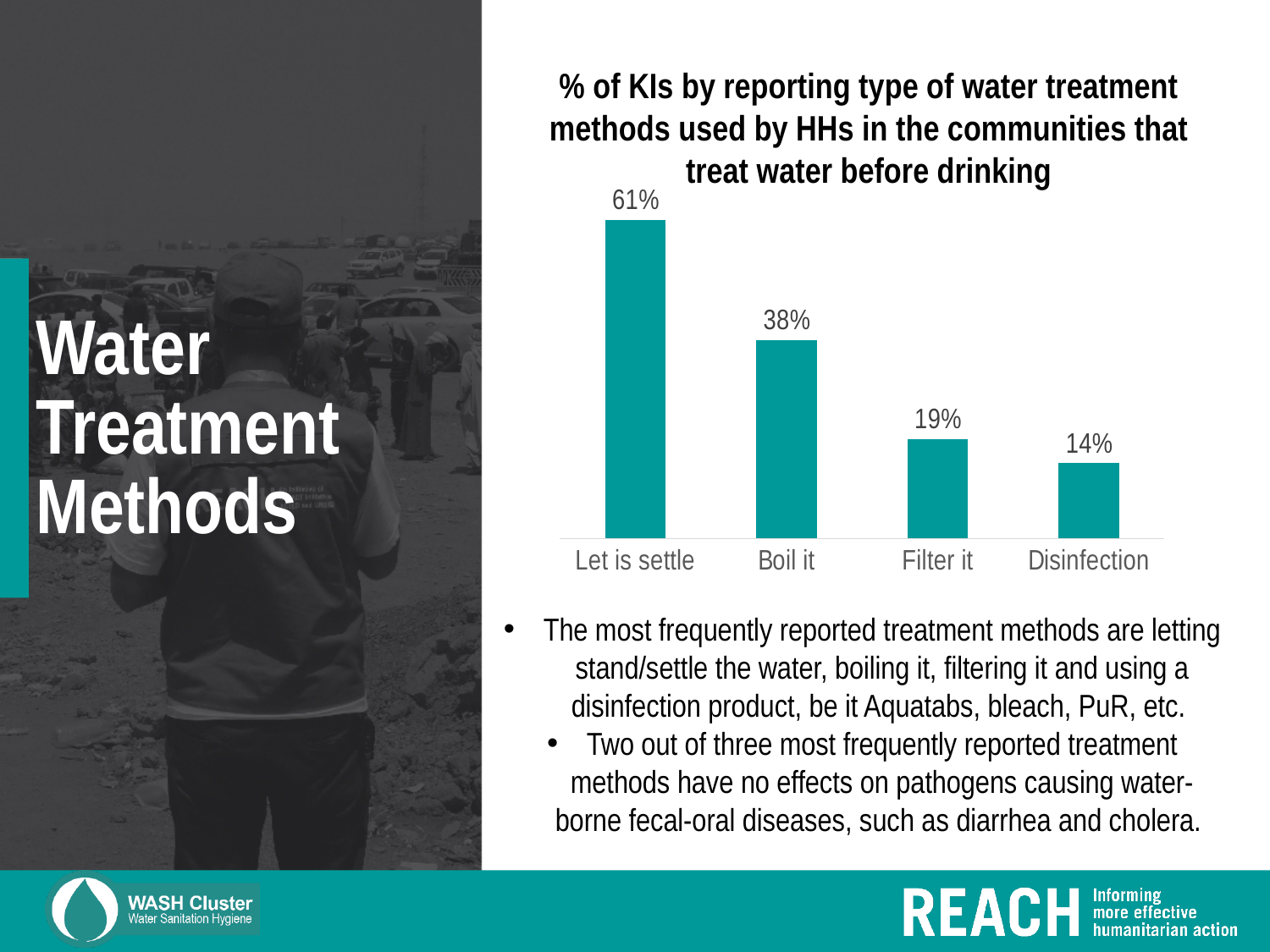
What type of chart is used to show the water treatment methods? Bar chart What is the difference in percentage points between 'Let is settle' and 'Boil it'? 23 What percentage of KIs reported 'Boil it' as a water treatment method? 38% Do the values rise or fall from left to right across the categories? Fall What percentage of KIs reported 'Filter it' as a water treatment method? 19% Which water treatment method has the lowest percentage of KIs reporting it? Disinfection What is the difference in percentage points between 'Filter it' and 'Disinfection'? 5 Which water treatment method has the highest percentage of KIs reporting it? Let is settle What percentage of KIs reported 'Let is settle' as a water treatment method? 61% Which has a higher percentage of KIs reporting it, 'Boil it' or 'Filter it'? Boil it What percentage of KIs reported 'Disinfection' as a water treatment method? 14% How many water treatment methods are shown in the chart? 4